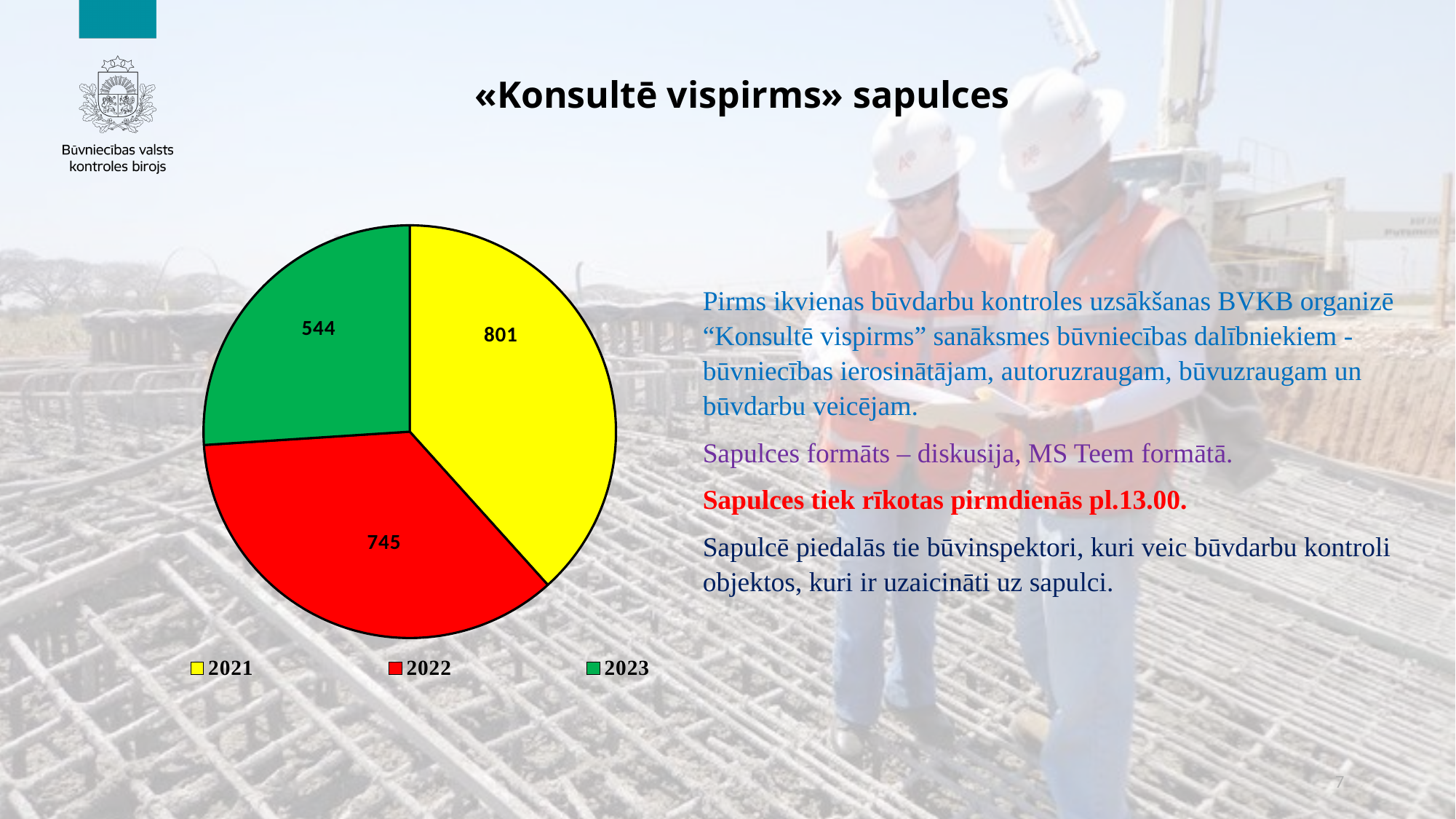
Which is larger, the value for 2021 or the value for 2022? 2021 What is the difference between the values for 2021 and 2023? 257 What is the value for 2023 in the pie chart? 544 How many slices does the pie chart have? 3 Which colour represents 2022 in the pie chart? red Which year has the smallest slice in the pie chart? 2023 Which year has the largest slice in the pie chart? 2021 What is the value for 2021 in the pie chart? 801 What is the difference between the values for 2022 and 2023? 201 What is the value for 2022 in the pie chart? 745 What is the total of all slices in the pie chart? 2090 What type of chart is shown on the slide? pie chart